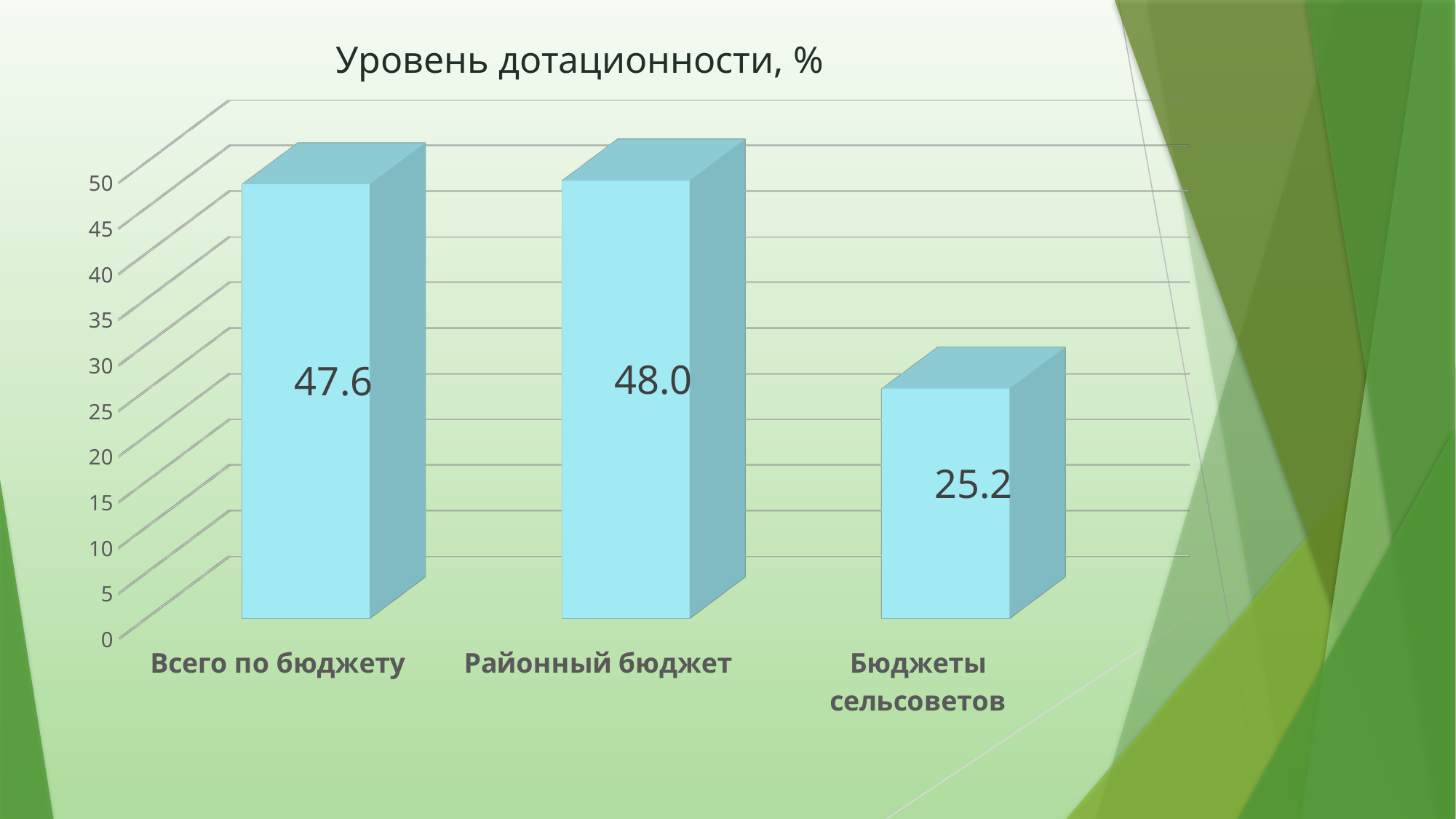
What is the value for Районный бюджет? 48.0 Which is larger, the value for Всего по бюджету or the value for Бюджеты сельсоветов? Всего по бюджету Is the value for Районный бюджет greater or less than 40? greater What is the title of the chart? Уровень дотационности, % What kind of chart is shown on the slide? bar chart What is the value for Всего по бюджету? 47.6 Which category has the lowest value? Бюджеты сельсоветов What is the value for Бюджеты сельсоветов? 25.2 How many categories are shown in the chart? 3 What is the difference between the values for Всего по бюджету and Бюджеты сельсоветов? 22.4 What is the difference between the values for Районный бюджет and Бюджеты сельсоветов? 22.8 Is the value for Бюджеты сельсоветов greater or less than 30? less